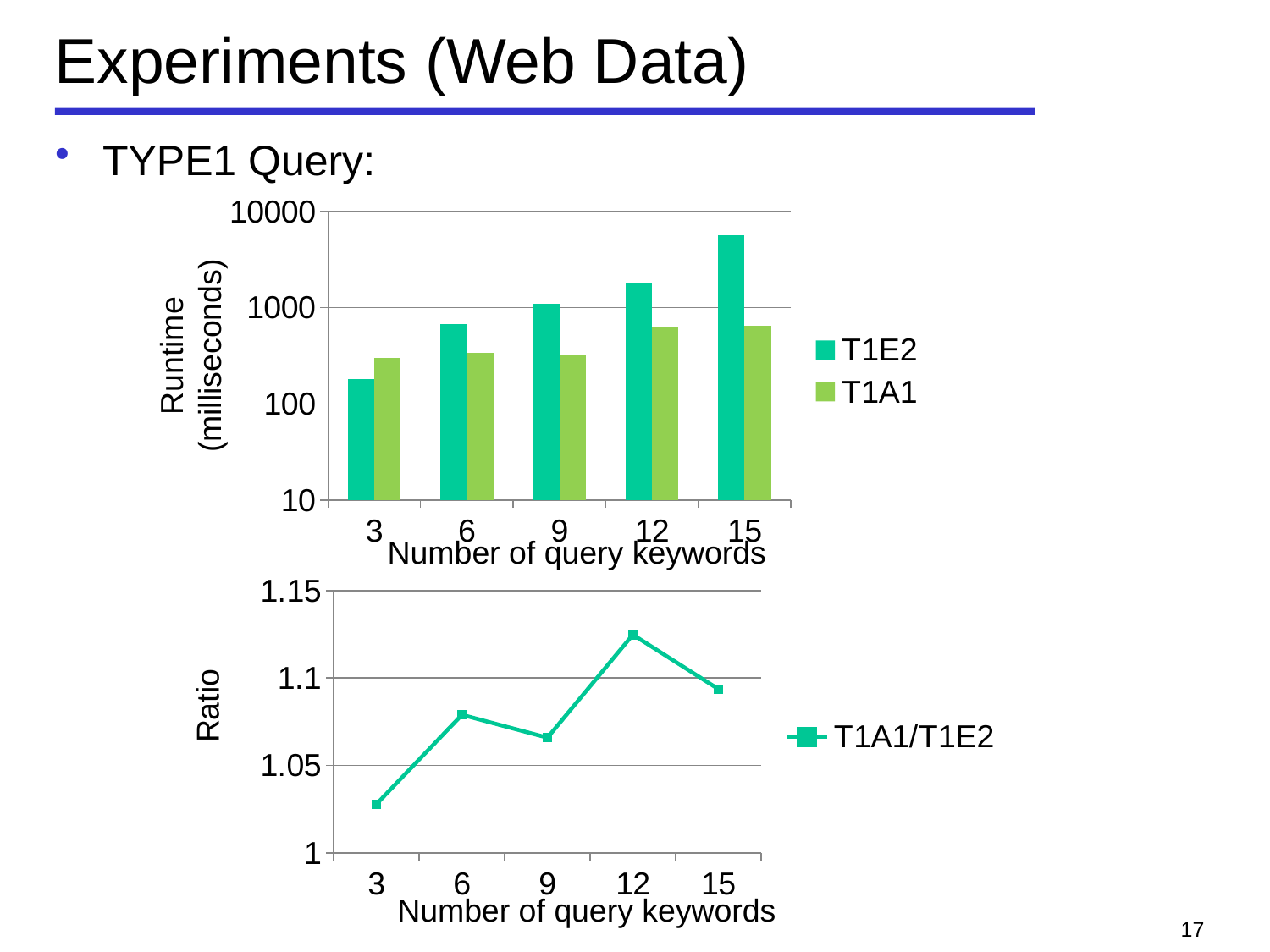
In the bottom chart, is the ratio for 12 query keywords greater or less than 1.1? greater In the top chart, how many series does the legend list? 2 In the bottom chart, at which number of query keywords is the T1A1/T1E2 ratio lowest? 3 What kind of chart is the top chart on the slide? bar chart In the top chart, does the T1E2 runtime rise or fall as the number of query keywords increases? rise In the top chart, at 15 query keywords, which series has the larger runtime, T1E2 or T1A1? T1E2 In the top chart, at 3 query keywords, which series has the larger runtime, T1E2 or T1A1? T1A1 In the top chart, is the T1E2 runtime for 15 query keywords greater or less than 1000? greater In the bottom chart, at which number of query keywords is the T1A1/T1E2 ratio highest? 12 In the top chart, is the T1E2 runtime for 3 query keywords greater or less than 1000? less In the top chart, at which number of query keywords is the T1E2 runtime highest? 15 What kind of chart is the bottom chart on the slide? line chart